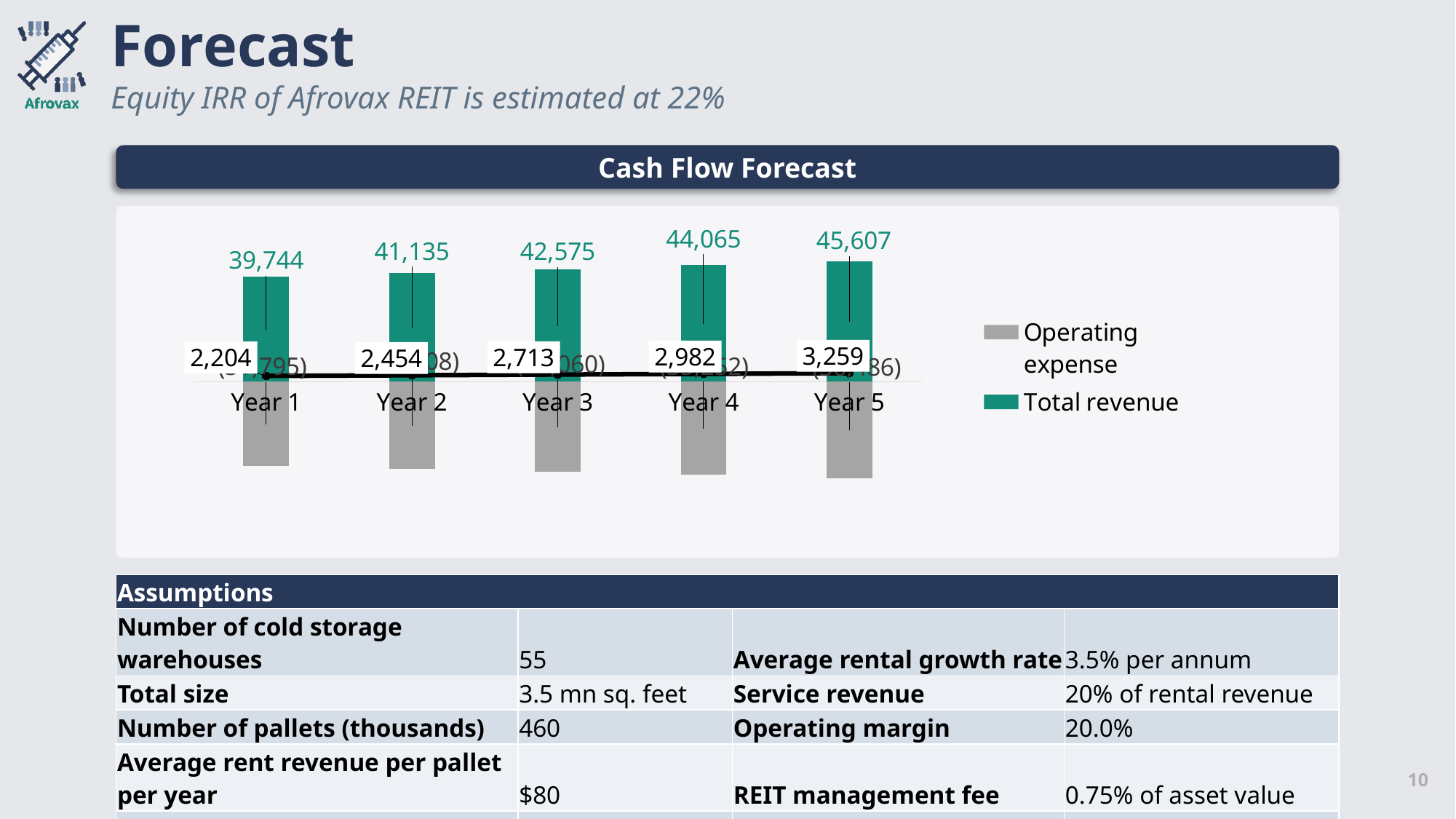
What is the Total revenue for Year 1 in the Cash Flow Forecast chart? 39,744 Which has the larger Total revenue, Year 2 or Year 4? Year 4 What is the title of the chart on the slide? Cash Flow Forecast How many series does the legend of the Cash Flow Forecast chart list? 2 What is the Total revenue for Year 5 in the Cash Flow Forecast chart? 45,607 What is the difference in Total revenue between Year 4 and Year 3? 1,490 Which year has the lowest Total revenue in the Cash Flow Forecast chart? Year 1 How many years are shown on the x axis of the Cash Flow Forecast chart? 5 Which year has the highest Total revenue in the Cash Flow Forecast chart? Year 5 By how much does Total revenue in Year 5 exceed Total revenue in Year 1? 5,863 What is the Total revenue for Year 3 in the Cash Flow Forecast chart? 42,575 Does Total revenue rise or fall from Year 1 to Year 5? rise